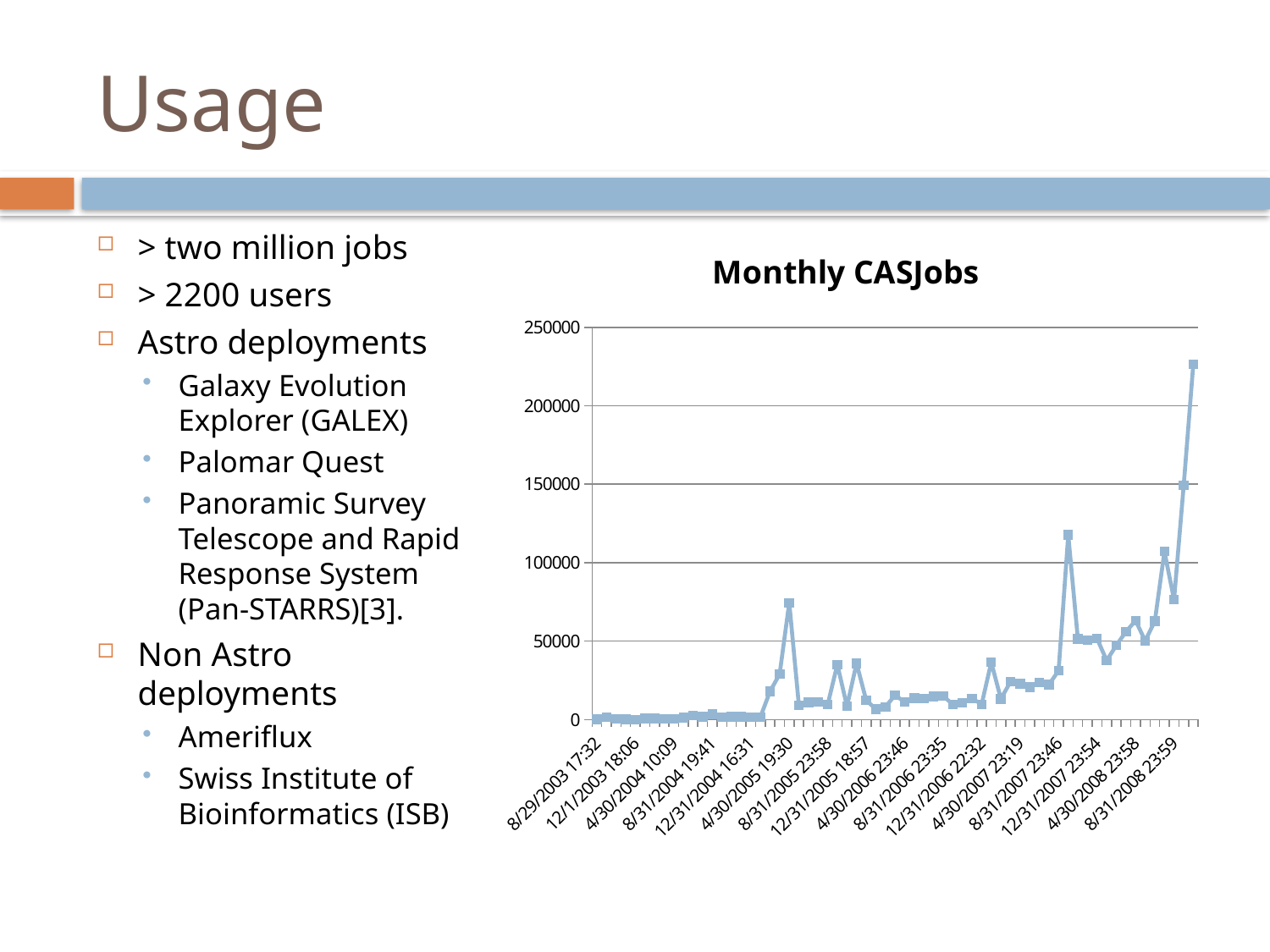
What is the title of the chart on the slide? Monthly CASJobs How many date labels are shown on the x axis of the Monthly CASJobs chart? 16 Is the value for 4/30/2008 23:58 greater or less than 150000? less Is the value for 8/29/2003 17:32 greater or less than 50000? less What is the highest tick value shown on the y axis of the Monthly CASJobs chart? 250000 Overall, do the values in the Monthly CASJobs chart rise or fall from left to right along the x axis? rise What kind of chart is the Monthly CASJobs chart? line chart Which has the larger value, 8/29/2003 17:32 or 8/31/2008 23:59? 8/31/2008 23:59 Is the value for 8/31/2008 23:59 greater or less than 200000? less